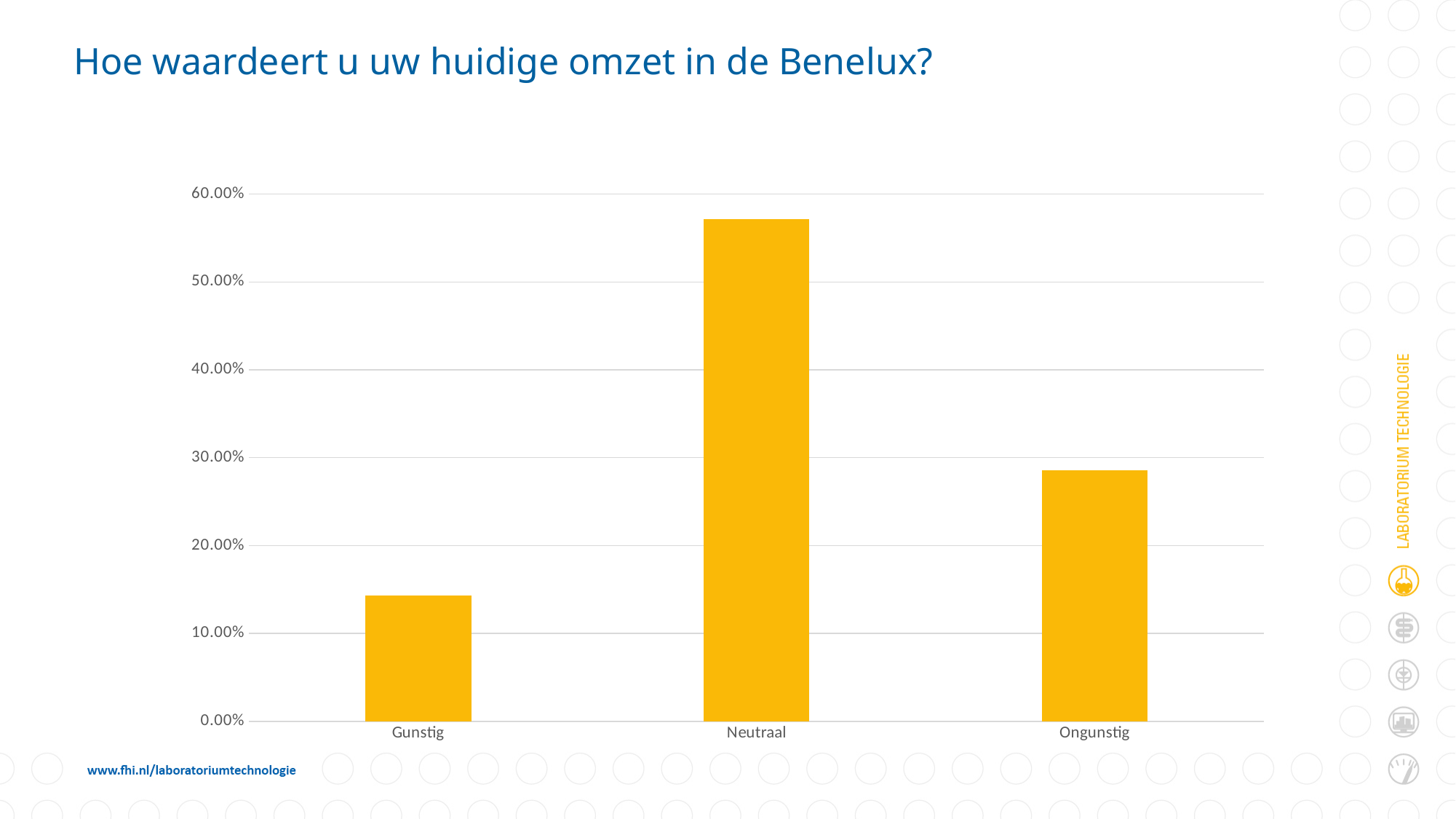
Is the value for Gunstig greater or less than 20.00%? less Is the value for Ongunstig greater or less than 30.00%? less Which is larger, the value for Ongunstig or the value for Gunstig? Ongunstig What is the title of the slide containing the chart? Hoe waardeert u uw huidige omzet in de Benelux? Which category has the lowest value in the chart? Gunstig What colour are the bars in the chart? yellow How many categories are shown on the x axis of the chart? 3 Is the value for Neutraal greater or less than 50.00%? greater Which category has the highest value in the chart? Neutraal What kind of chart is shown on the slide? bar chart Which is larger, the value for Neutraal or the value for Ongunstig? Neutraal